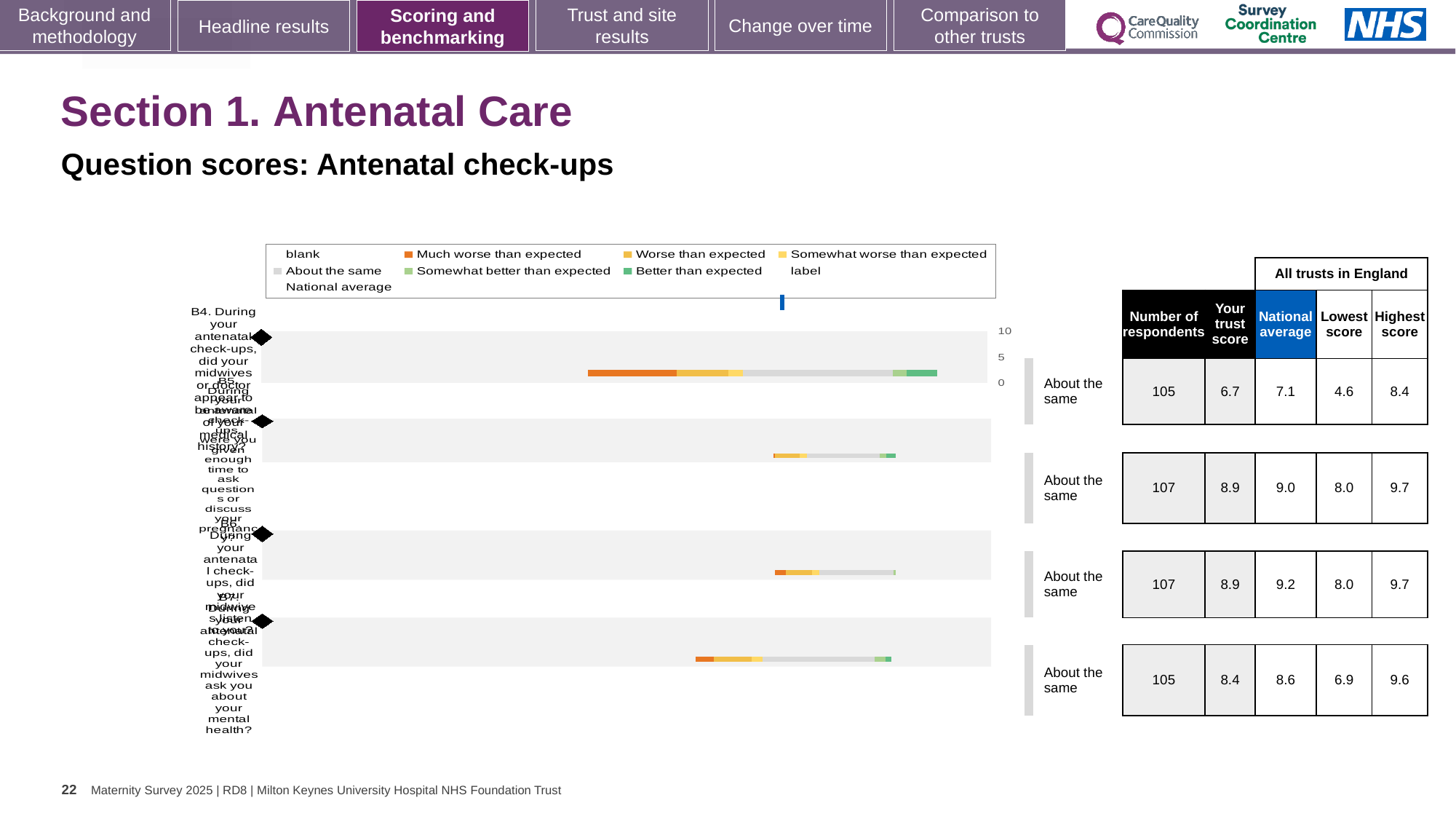
How many question rows (bars) are plotted in the chart? 4 What is the difference between the national average and the trust score for the first (top) question row, B4? 0.4 What is the highest score across all trusts in England for the third question row, B6? 9.7 What is the number of respondents for the fourth (bottom) question row, B7? 105 What kind of chart is shown on the slide? bar chart What is the 'Your trust score' for the first (top) question row, B4? 6.7 In the chart legend, what colour represents 'Much worse than expected'? orange What is the national average for the first (top) question row, B4? 7.1 Which question row has the lowest 'Your trust score'? B4 (top row) What is the lowest score across all trusts in England for the first (top) question row, B4? 4.6 What is the benchmark category shown next to every bar in the chart? About the same For the fourth (bottom) question row, B7, which is larger: the trust score or the national average? National average